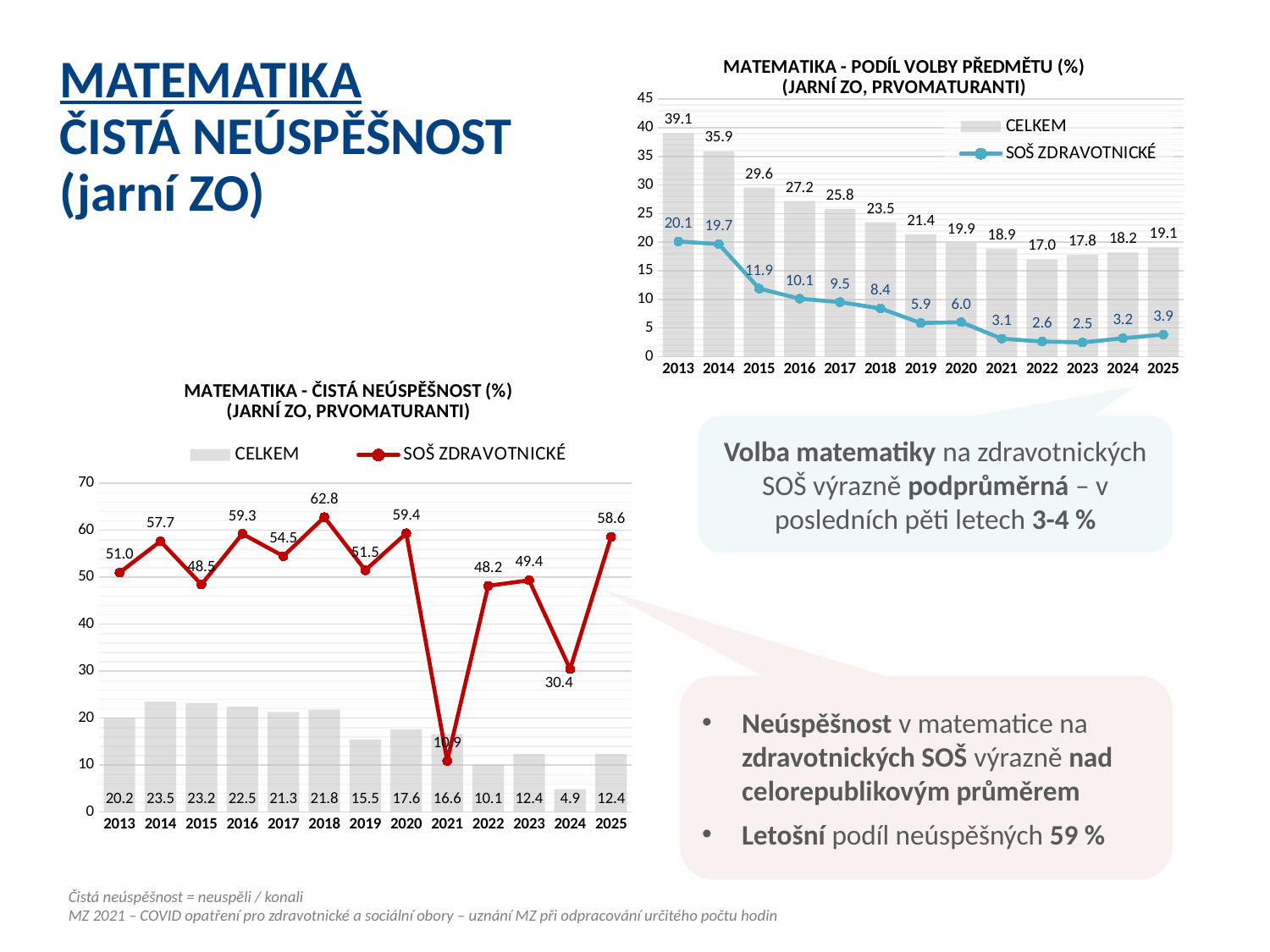
In the chart titled 'MATEMATIKA - PODÍL VOLBY PŘEDMĚTU (%)', does the SOŠ ZDRAVOTNICKÉ line generally rise or fall from 2013 to 2023? fall In the chart titled 'MATEMATIKA - PODÍL VOLBY PŘEDMĚTU (%)', what is the SOŠ ZDRAVOTNICKÉ value for 2025? 3.9 In the chart titled 'MATEMATIKA - PODÍL VOLBY PŘEDMĚTU (%)', what is the difference between the CELKEM and SOŠ ZDRAVOTNICKÉ values in 2021? 15.8 In the chart titled 'MATEMATIKA - ČISTÁ NEÚSPĚŠNOST (%)', what is the CELKEM value for 2024? 4.9 In the chart titled 'MATEMATIKA - ČISTÁ NEÚSPĚŠNOST (%)', which year has the highest SOŠ ZDRAVOTNICKÉ value? 2018 In the chart titled 'MATEMATIKA - PODÍL VOLBY PŘEDMĚTU (%)', which year has the lowest SOŠ ZDRAVOTNICKÉ value? 2023 In the chart titled 'MATEMATIKA - ČISTÁ NEÚSPĚŠNOST (%)', what is the SOŠ ZDRAVOTNICKÉ value for 2018? 62.8 In the chart titled 'MATEMATIKA - ČISTÁ NEÚSPĚŠNOST (%)', how many years are shown on the x axis? 13 In the chart titled 'MATEMATIKA - PODÍL VOLBY PŘEDMĚTU (%)', how many series does the legend list? 2 In the chart titled 'MATEMATIKA - ČISTÁ NEÚSPĚŠNOST (%)', which is larger in 2021: the CELKEM value or the SOŠ ZDRAVOTNICKÉ value? CELKEM In the chart titled 'MATEMATIKA - PODÍL VOLBY PŘEDMĚTU (%)', what is the CELKEM value for 2013? 39.1 In the chart titled 'MATEMATIKA - ČISTÁ NEÚSPĚŠNOST (%)', what is the difference between the SOŠ ZDRAVOTNICKÉ and CELKEM values in 2025? 46.2